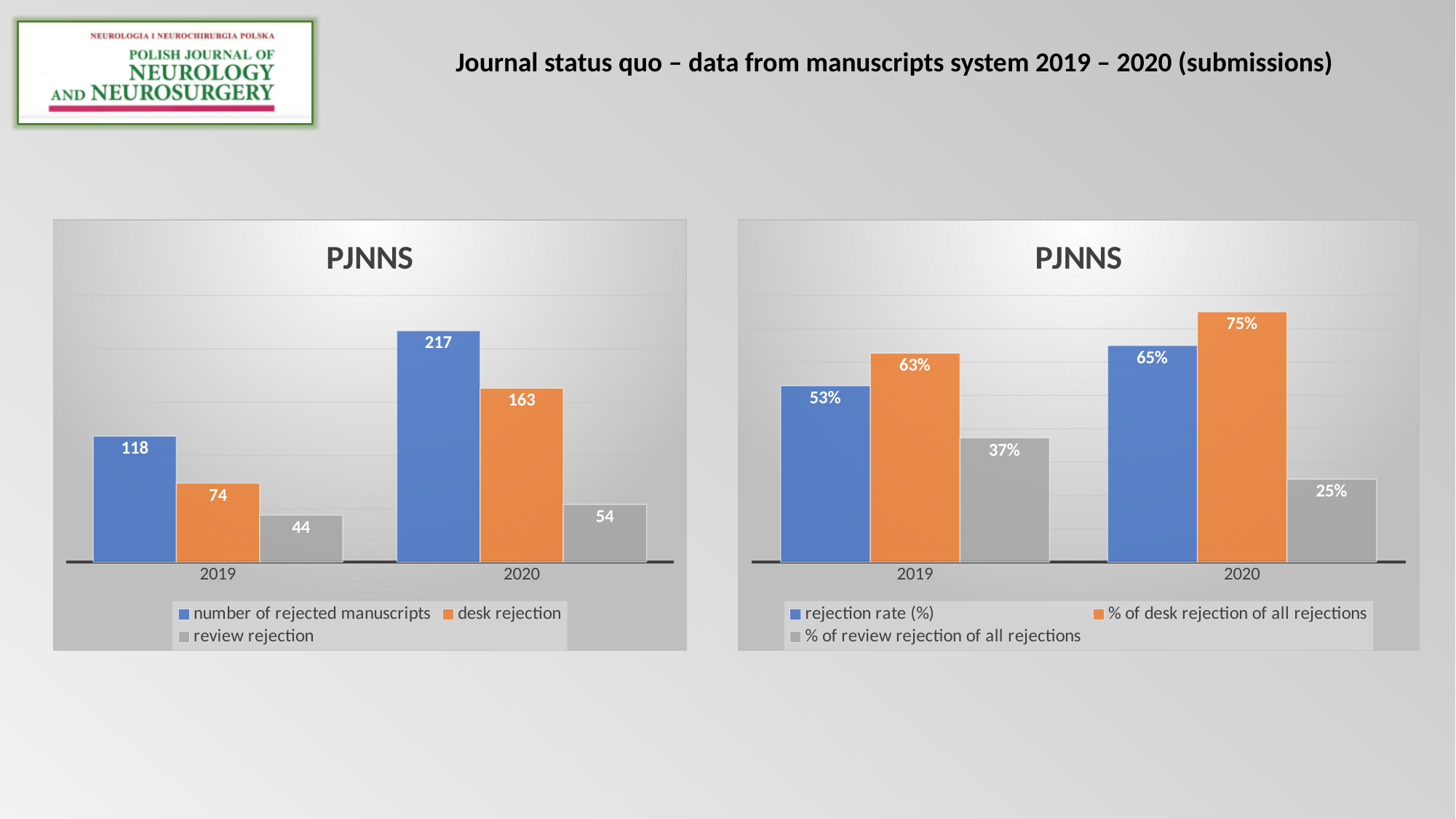
In the left chart, what is the desk rejection value for 2019? 74 In the left chart, which is larger: desk rejection in 2020 or number of rejected manuscripts in 2019? desk rejection in 2020 What type of chart is the right chart? bar chart How many series does the legend of the left chart list? 3 In the left chart, what is the review rejection value for 2020? 54 In the left chart, by how much did the number of rejected manuscripts increase from 2019 to 2020? 99 In the right chart, what is the difference between the % of desk rejection of all rejections in 2020 and in 2019? 12% In the right chart, does the % of review rejection of all rejections rise or fall from 2019 to 2020? fall In the right chart, what is the % of desk rejection of all rejections in 2020? 75% In the left chart, what is the number of rejected manuscripts in 2020? 217 In the right chart, what is the rejection rate (%) for 2019? 53% In the right chart, what is the % of review rejection of all rejections in 2019? 37%